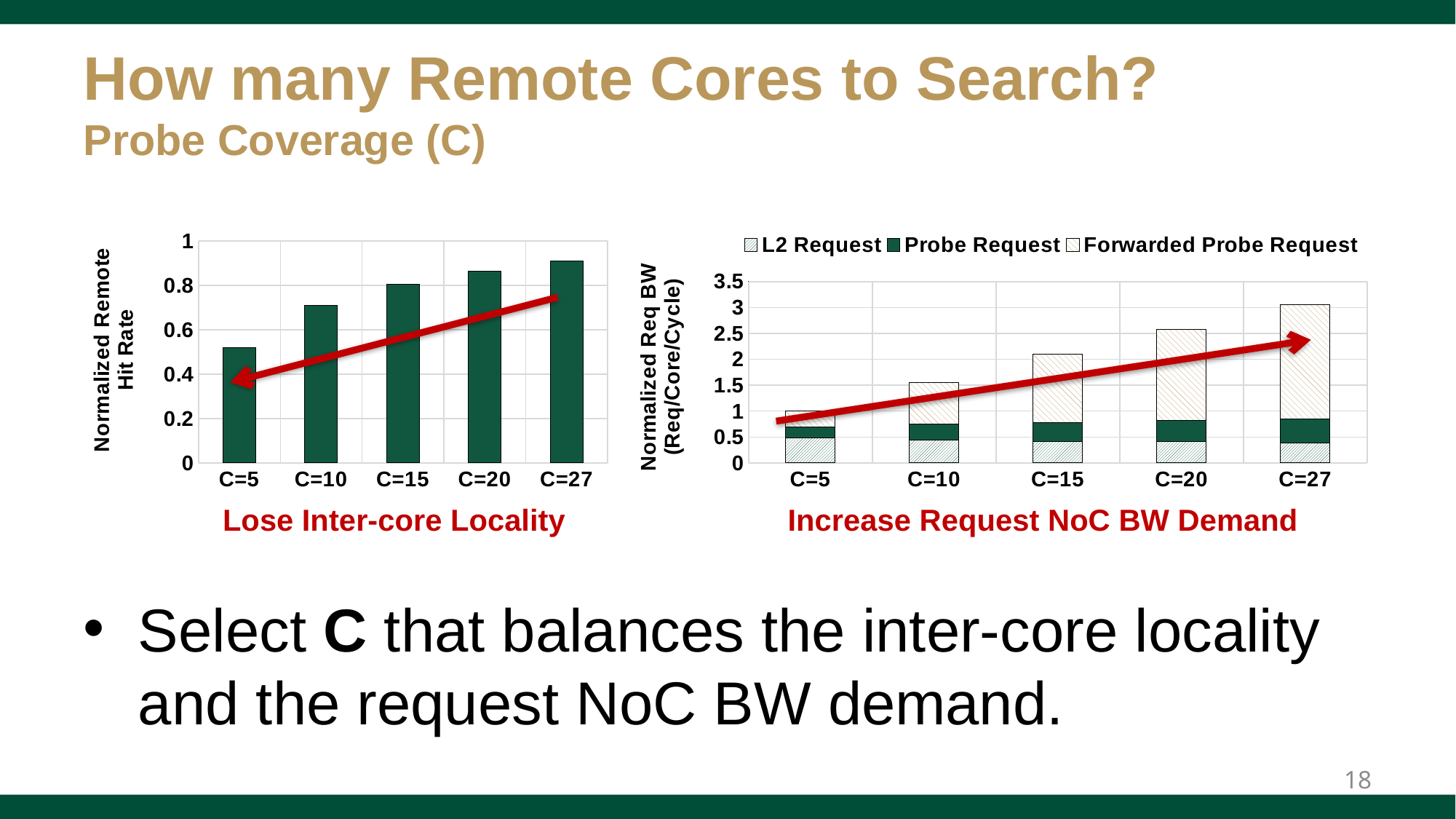
On the left chart (Normalized Remote Hit Rate), is the value for C=27 greater or less than 0.8? greater On the right chart (Normalized Req BW), which category has the tallest stacked bar? C=27 On the left chart (Normalized Remote Hit Rate), which category has the highest bar? C=27 On the left chart (Normalized Remote Hit Rate), is the value for C=5 greater or less than 0.6? less On the right chart (Normalized Req BW), is the total stacked value for C=5 greater or less than 1.5? less On the right chart (Normalized Req BW), what kind of chart is it? stacked bar chart On the left chart (Normalized Remote Hit Rate), how many categories are shown on the x axis? 5 On the right chart (Normalized Req BW), how many series does the legend list? 3 On the left chart (Normalized Remote Hit Rate), do the values rise or fall as C increases along the x axis? rise On the left chart (Normalized Remote Hit Rate), which category has the lowest bar? C=5